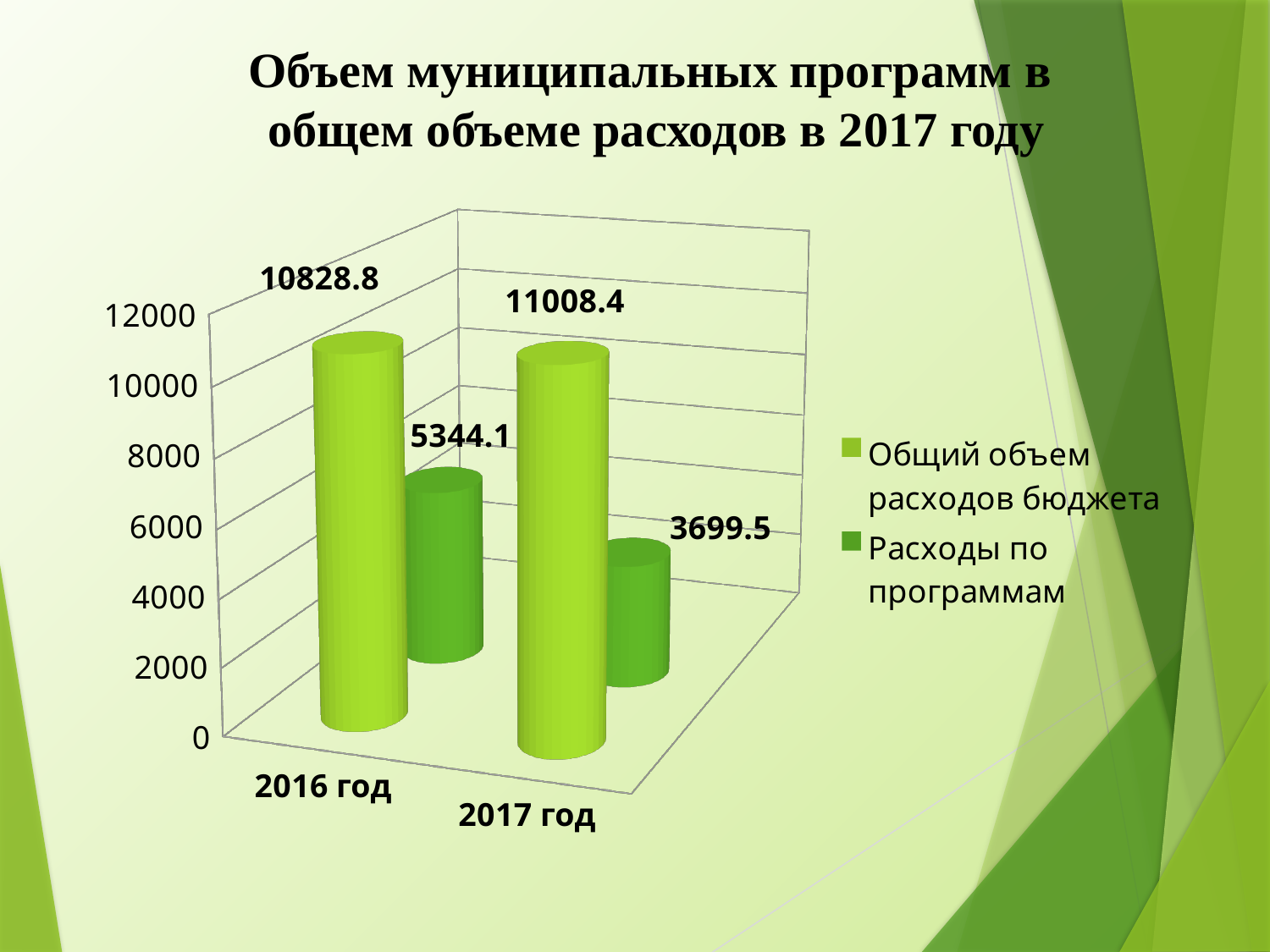
By how much did Расходы по программам decrease from 2016 год to 2017 год? 1644.6 Which year has the lower value for Общий объем расходов бюджета? 2016 год What kind of chart is shown on the slide? Bar chart What is the difference between Общий объем расходов бюджета and Расходы по программам in 2017 год? 7308.9 What is the value of Расходы по программам for 2016 год? 5344.1 How many series does the legend list? 2 What is the value of Расходы по программам for 2017 год? 3699.5 What is the value of Общий объем расходов бюджета for 2016 год? 10828.8 Which year has the higher value for Расходы по программам? 2016 год What is the value of Общий объем расходов бюджета for 2017 год? 11008.4 Does Расходы по программам rise or fall from 2016 год to 2017 год? Fall Is the value of Расходы по программам for 2016 год greater or less than 4000? greater